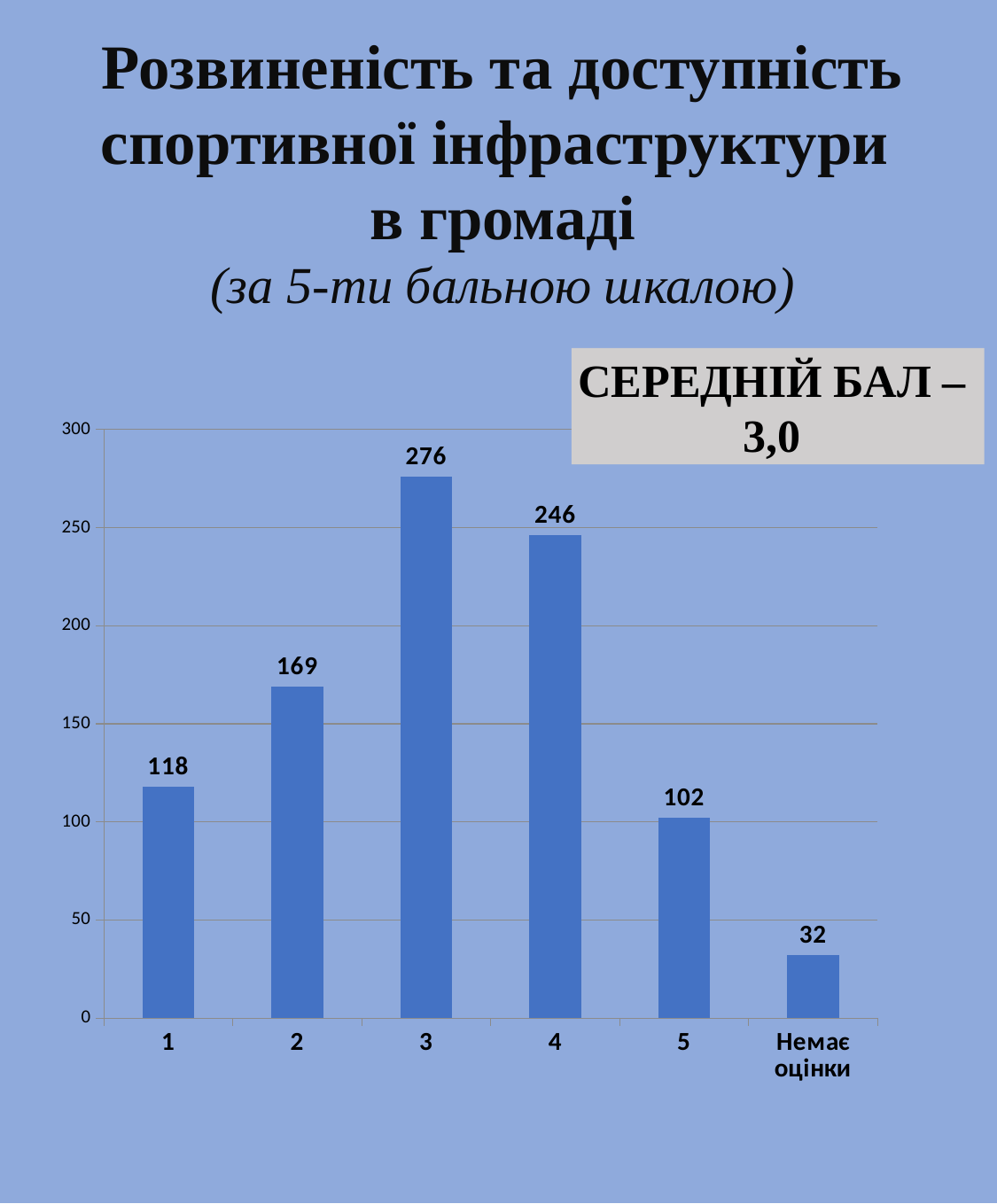
What is the value for the category "Немає оцінки"? 32 What is the value for category 3? 276 What is the difference between the values for category 2 and category 1? 51 What average score (СЕРЕДНІЙ БАЛ) is stated in the box on the slide? 3,0 Is the value for category 4 greater or less than 200? greater How many categories are shown on the x axis? 6 What is the value for category 5? 102 What kind of chart is shown on the slide? bar chart Which category has the lowest value? Немає оцінки Which is larger, the value for category 1 or the value for category 5? 1 What is the difference between the values for category 3 and category 4? 30 Which category has the highest value? 3